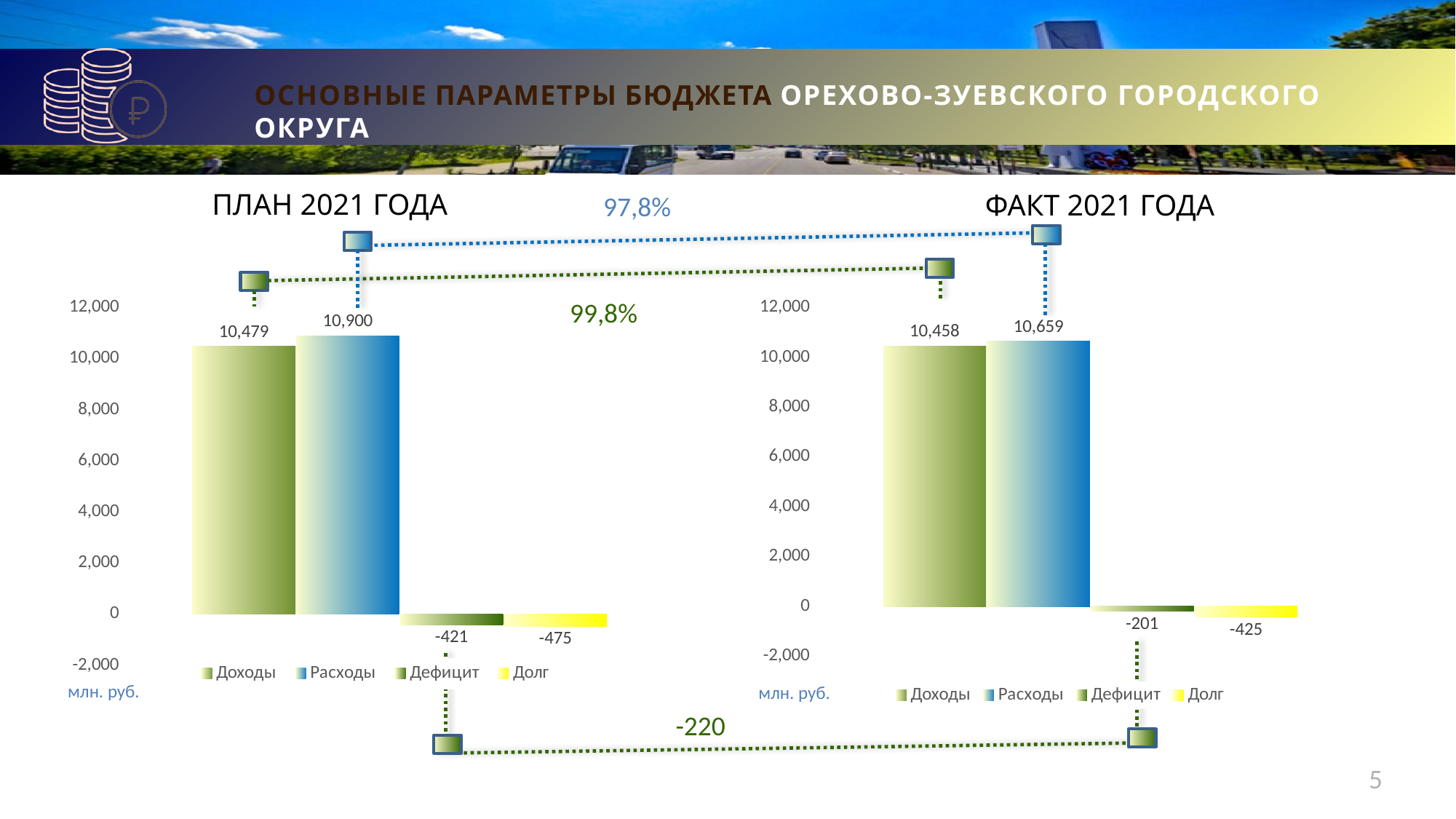
In the ПЛАН 2021 ГОДА chart, which series has the lowest value? Долг What unit is shown below the axis of the ПЛАН 2021 ГОДА chart? млн. руб. In the ПЛАН 2021 ГОДА chart, what is the value for Доходы? 10,479 In the ФАКТ 2021 ГОДА chart, which series has the highest value? Расходы In the ФАКТ 2021 ГОДА chart, what is the value for Долг? -425 In the ФАКТ 2021 ГОДА chart, what is the difference between Расходы and Доходы? 201 What type of chart is the ПЛАН 2021 ГОДА chart? bar chart Which is larger: Доходы in the ПЛАН 2021 ГОДА chart or Доходы in the ФАКТ 2021 ГОДА chart? ПЛАН 2021 ГОДА In the ПЛАН 2021 ГОДА chart, what is the difference between Расходы and Доходы? 421 In the ФАКТ 2021 ГОДА chart, what is the value for Дефицит? -201 In the ПЛАН 2021 ГОДА chart, what is the value for Расходы? 10,900 How many series does the legend of the ФАКТ 2021 ГОДА chart list? 4